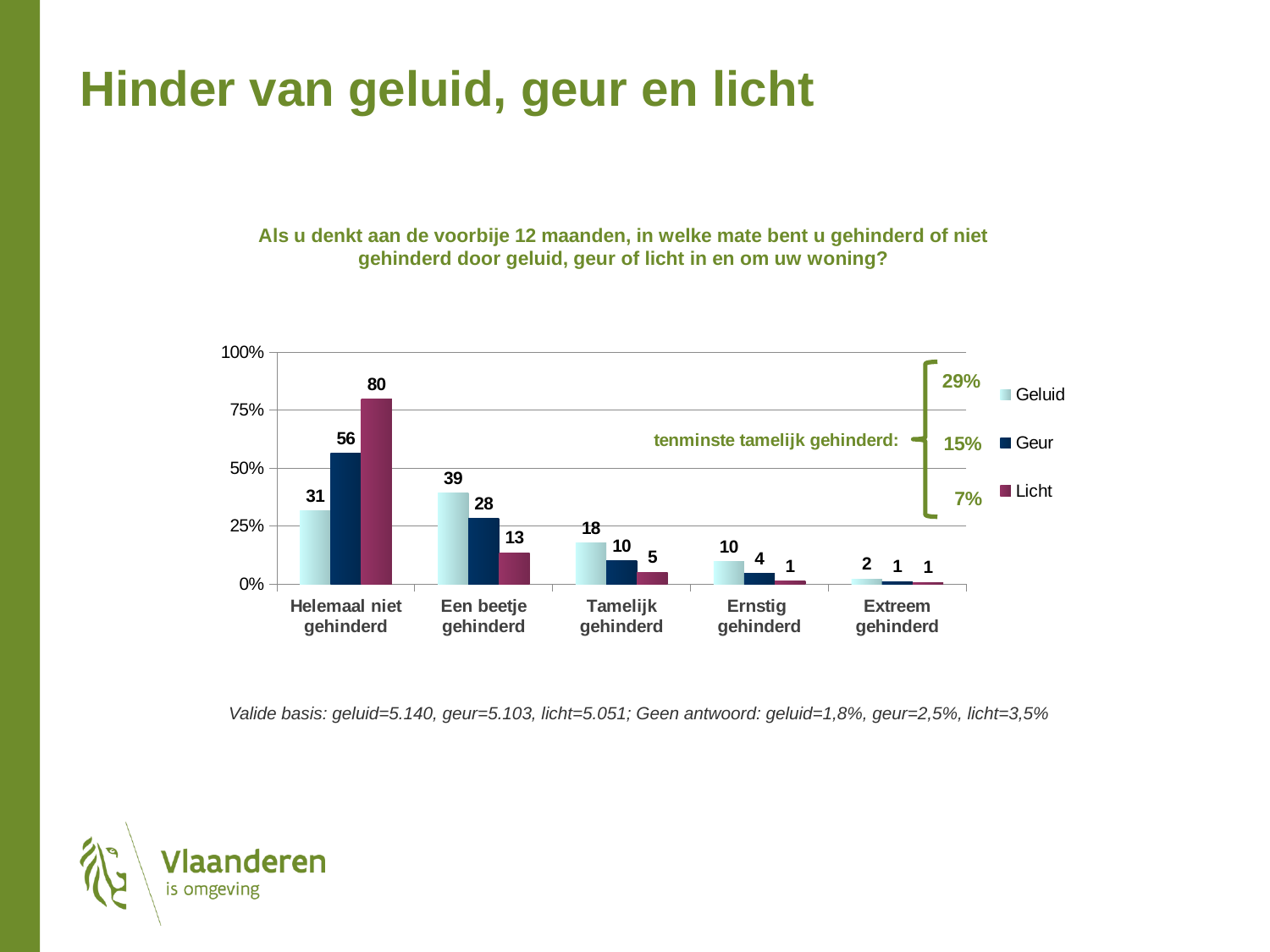
What is the value for Geluid in the 'Helemaal niet gehinderd' category? 31 In the 'Een beetje gehinderd' category, which series has the larger value, Geluid or Licht? Geluid What is the value for Geluid in the 'Tamelijk gehinderd' category? 18 What is the value for Licht in the 'Helemaal niet gehinderd' category? 80 What is the value for Geur in the 'Een beetje gehinderd' category? 28 Which category has the highest value for the Geur series? Helemaal niet gehinderd How many categories are shown on the x axis? 5 Which category has the lowest value for the Geluid series? Extreem gehinderd How many series does the legend list? 3 What is the difference between the Licht and Geluid values in the 'Helemaal niet gehinderd' category? 49 What kind of chart is shown on the slide? Bar chart According to the annotation, what percentage is at least 'tamelijk gehinderd' by Geluid? 29%